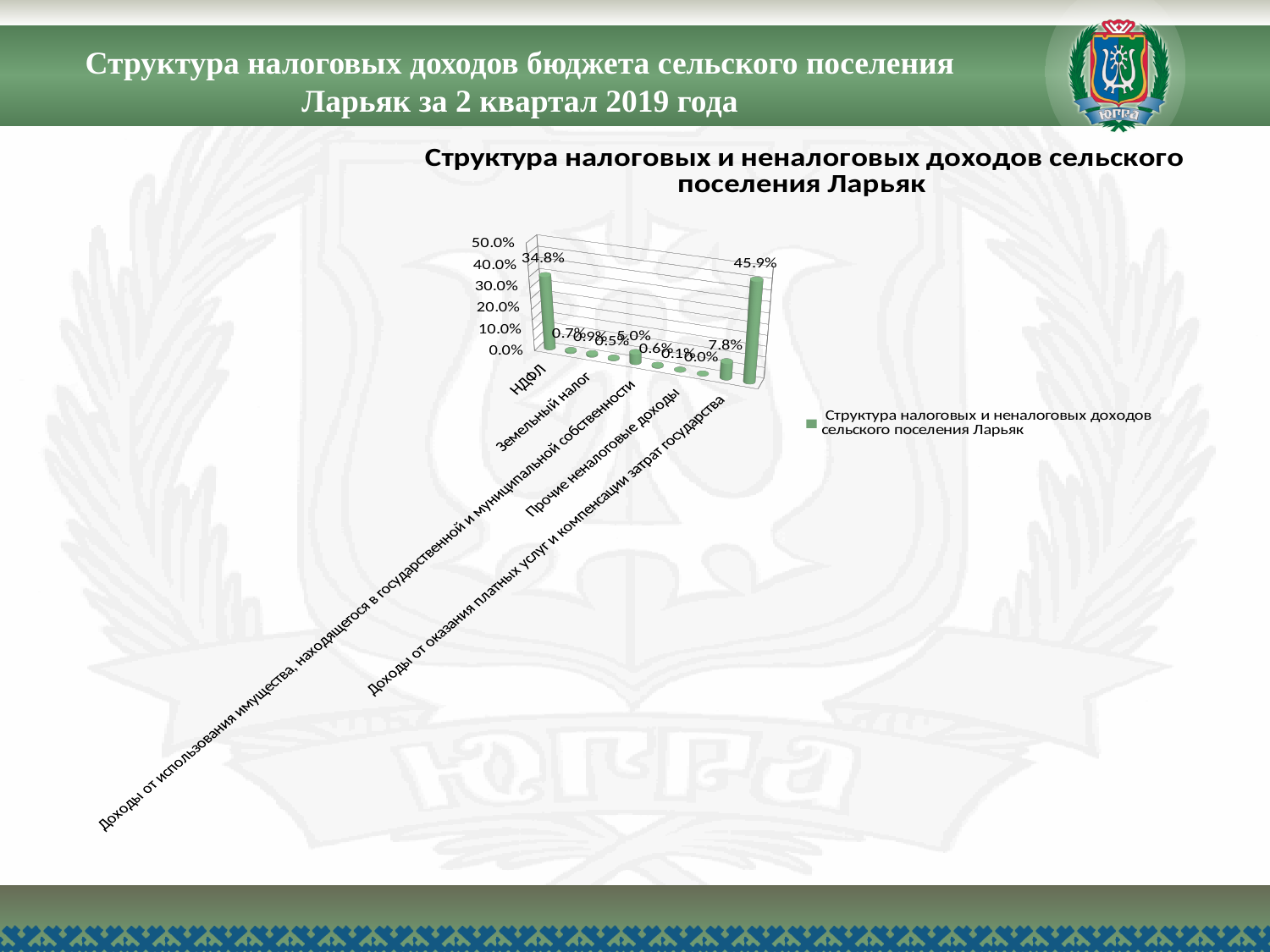
Is the value for НДФЛ greater or less than 30.0%? greater What is the difference between the highest value (45.9%) and the value for НДФЛ (34.8%)? 11.1% What is the maximum value shown on the vertical axis? 50.0% How many bars are plotted in the chart? 10 What type of chart is shown on the slide? bar chart What is the value shown for НДФЛ? 34.8% Which is larger: the value for НДФЛ or the tallest bar at the right end of the chart? the tallest bar at the right end (45.9%) What is the lowest value shown in the chart? 0.0% How many series does the legend list? 1 What is the highest value shown in the chart? 45.9% What is the title of the chart? Структура налоговых и неналоговых доходов сельского поселения Ларьяк